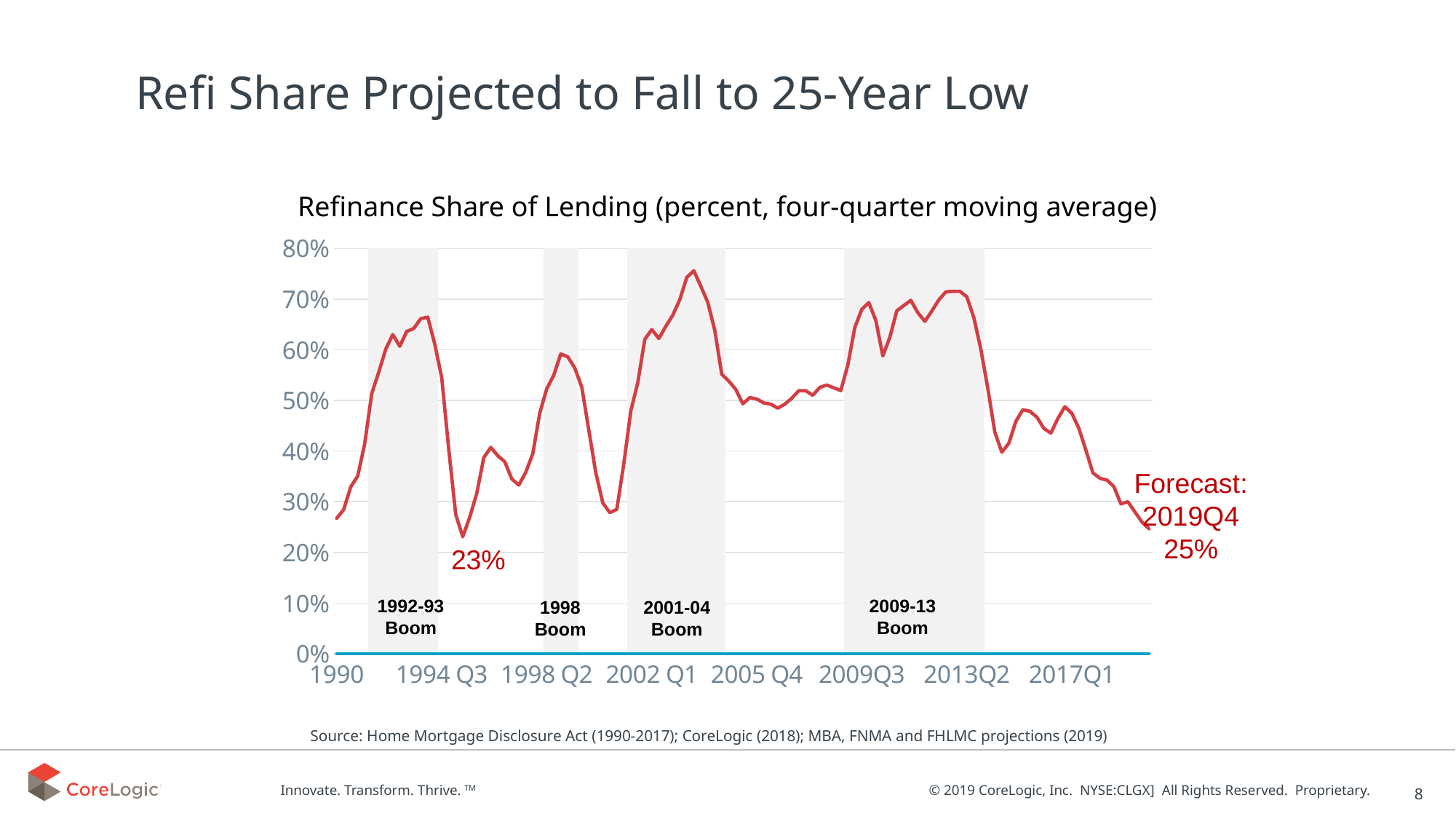
Does the refinance share rise or fall from 2017Q1 to the 2019Q4 forecast? fall Is the refinance share at the start of the series in 1990 greater or less than 30%? less Which peak is higher: the one during the 1992-93 Boom or the one during the 2001-04 Boom? 2001-04 Boom Is the peak refinance share during the 1998 Boom greater or less than 50%? greater Is the peak refinance share during the 2001-04 Boom greater or less than 70%? greater What is the difference between the 2019Q4 forecast value and the mid-1990s low labeled on the chart? 2 percentage points How many shaded boom periods are marked on the chart? 4 Which shaded boom period contains the highest peak of the refinance share? 2001-04 Boom What kind of chart is shown on the slide? line chart What is the forecast refinance share of lending for 2019Q4? 25% What is the labeled low value of the refinance share reached in the mid-1990s? 23%